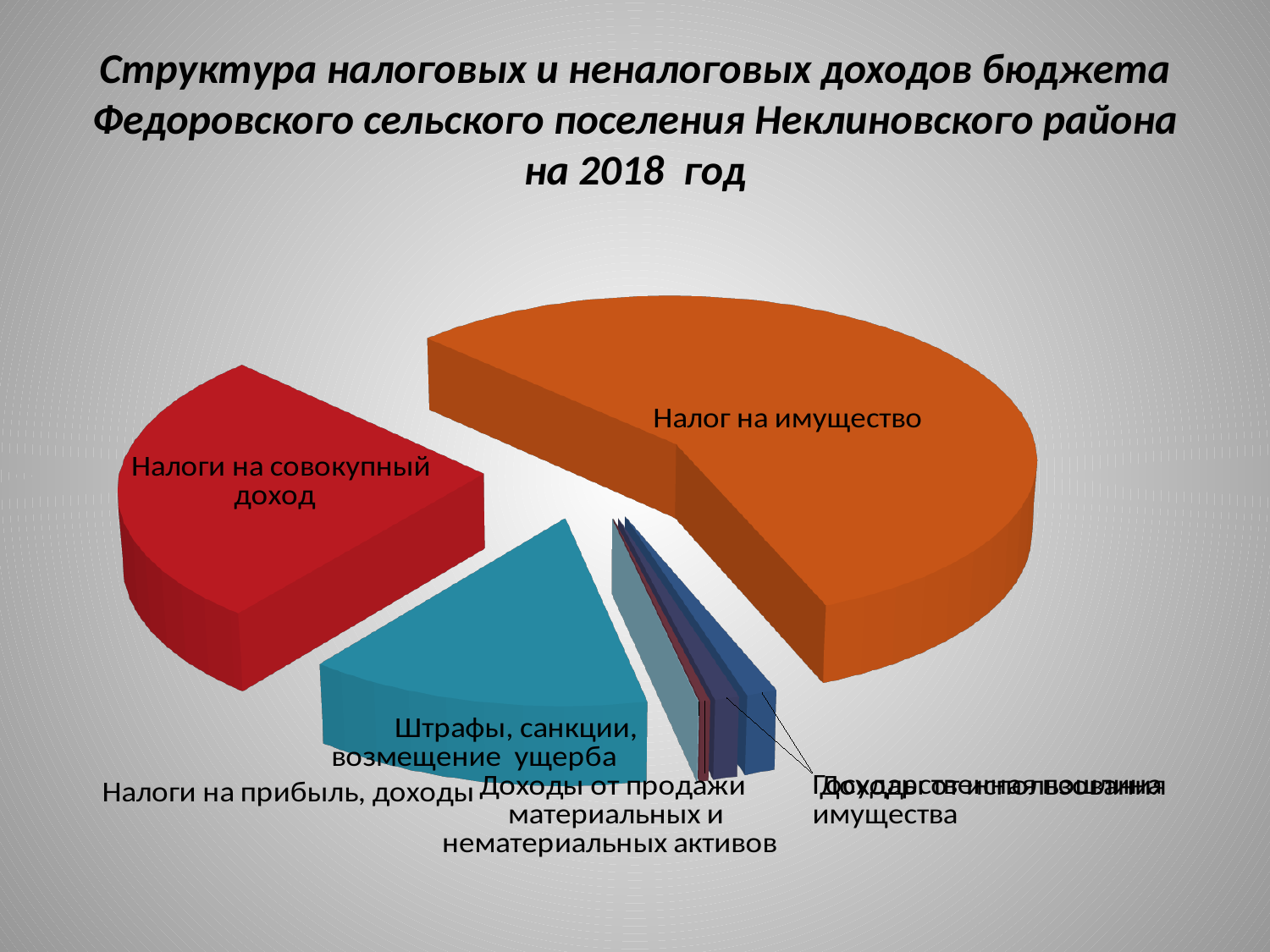
Which slice is larger: Налоги на совокупный доход or Налоги на прибыль, доходы? Налоги на совокупный доход Which slice is larger: Налог на имущество or Налоги на прибыль, доходы? Налог на имущество Which slice is larger: Налог на имущество or Налоги на совокупный доход? Налог на имущество Which year does the chart's title say the budget structure refers to? 2018 What colour is the slice for Налог на имущество? Orange Which category has the largest slice of the pie? Налог на имущество What kind of chart is shown on the slide? Pie chart